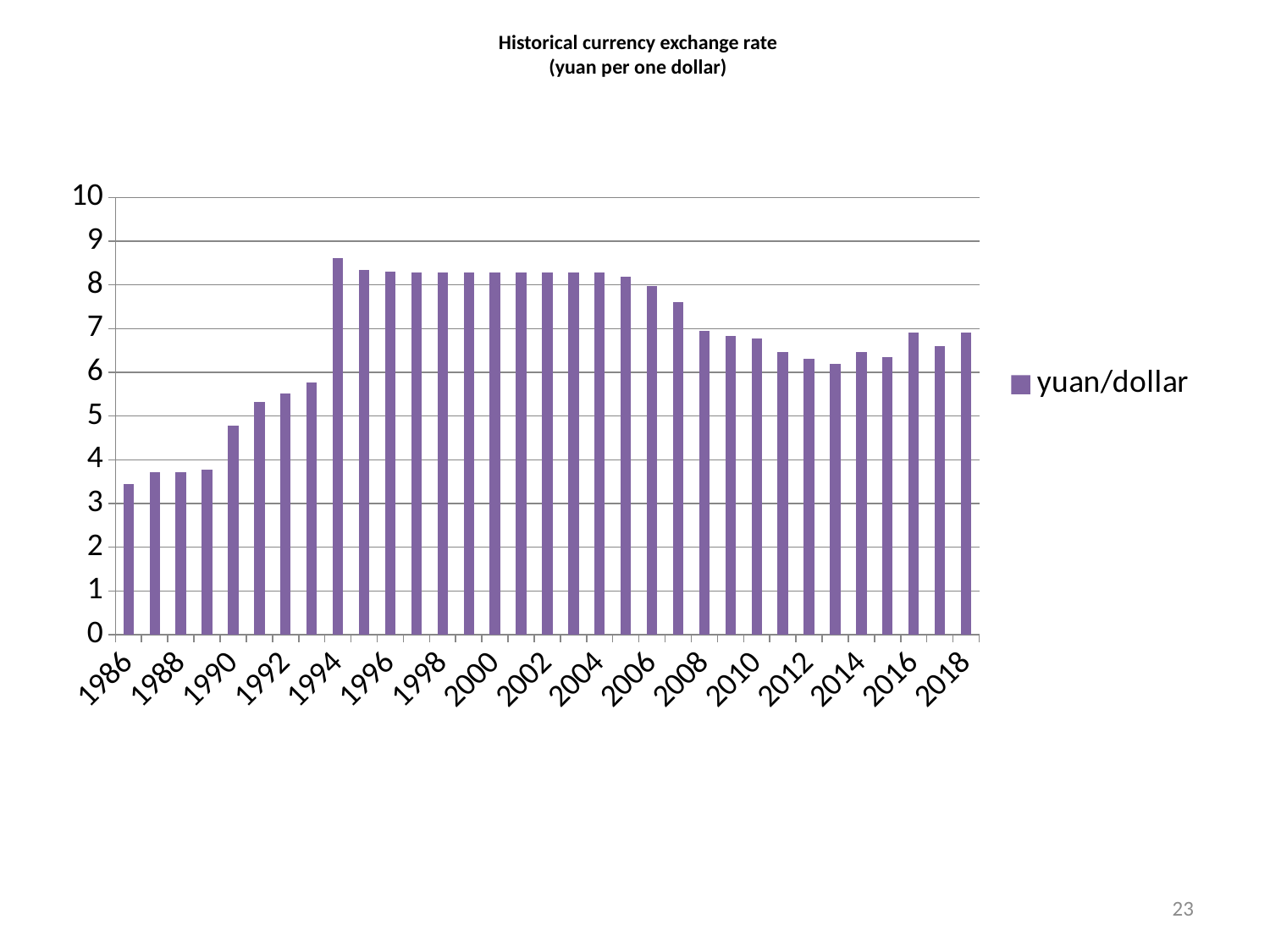
Do the values rise or fall from 1986 to 1994? rise How many years (bars) are plotted in the chart? 33 What kind of chart is shown on the slide? bar chart What is the legend entry for the series shown? yuan/dollar Is the value for 1986 greater or less than 4? less Which is larger, the value for 1990 or the value for 1986? 1990 Which year has the lowest yuan/dollar value? 1986 What is the title of the chart? Historical currency exchange rate (yuan per one dollar) How many series does the legend list? 1 Is the value for 2013 greater or less than 6? greater Which year has the highest yuan/dollar value? 1994 Is the value for 1994 greater or less than 8? greater